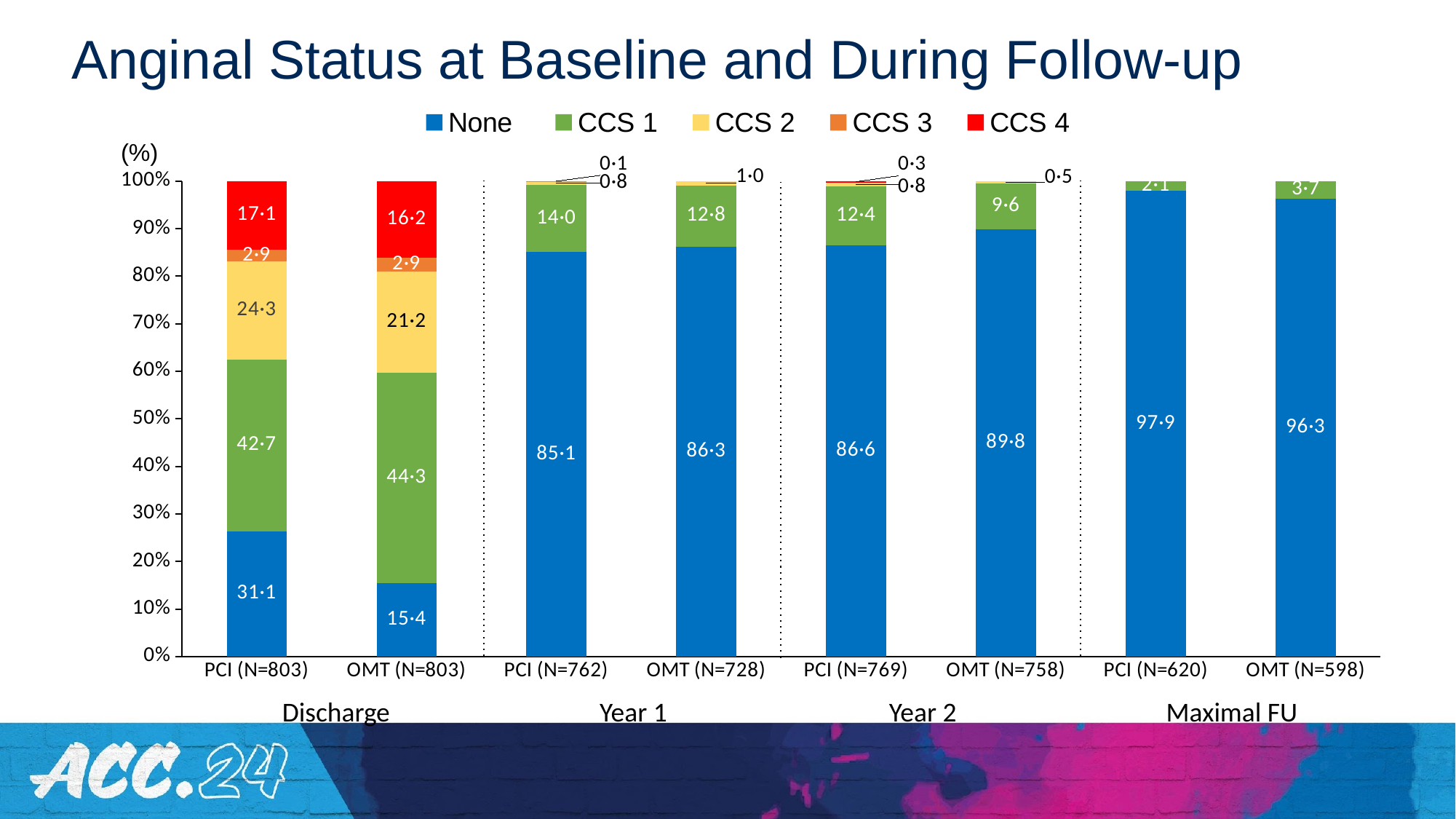
What is the value of the CCS 1 segment for OMT (N=758) at Year 2? 9·6 What is the value of the None segment for PCI (N=803) at Discharge? 31·1 How many series does the legend list? 5 What is the value of the CCS 4 segment for OMT (N=803) at Discharge? 16·2 What is the value of the None segment for PCI (N=620) at Maximal FU? 97·9 What is the difference between the None values for PCI (N=803) and OMT (N=803) at Discharge? 15·7 Which bar has the lowest value for the None segment? OMT (N=803) at Discharge At Discharge, which group has the larger CCS 2 segment, PCI (N=803) or OMT (N=803)? PCI (N=803) How many bars are plotted in the chart? 8 What kind of chart is shown on the slide? Stacked bar chart Is the None value for OMT (N=728) at Year 1 greater or less than 80%? greater Which bar has the highest value for the None segment? PCI (N=620) at Maximal FU